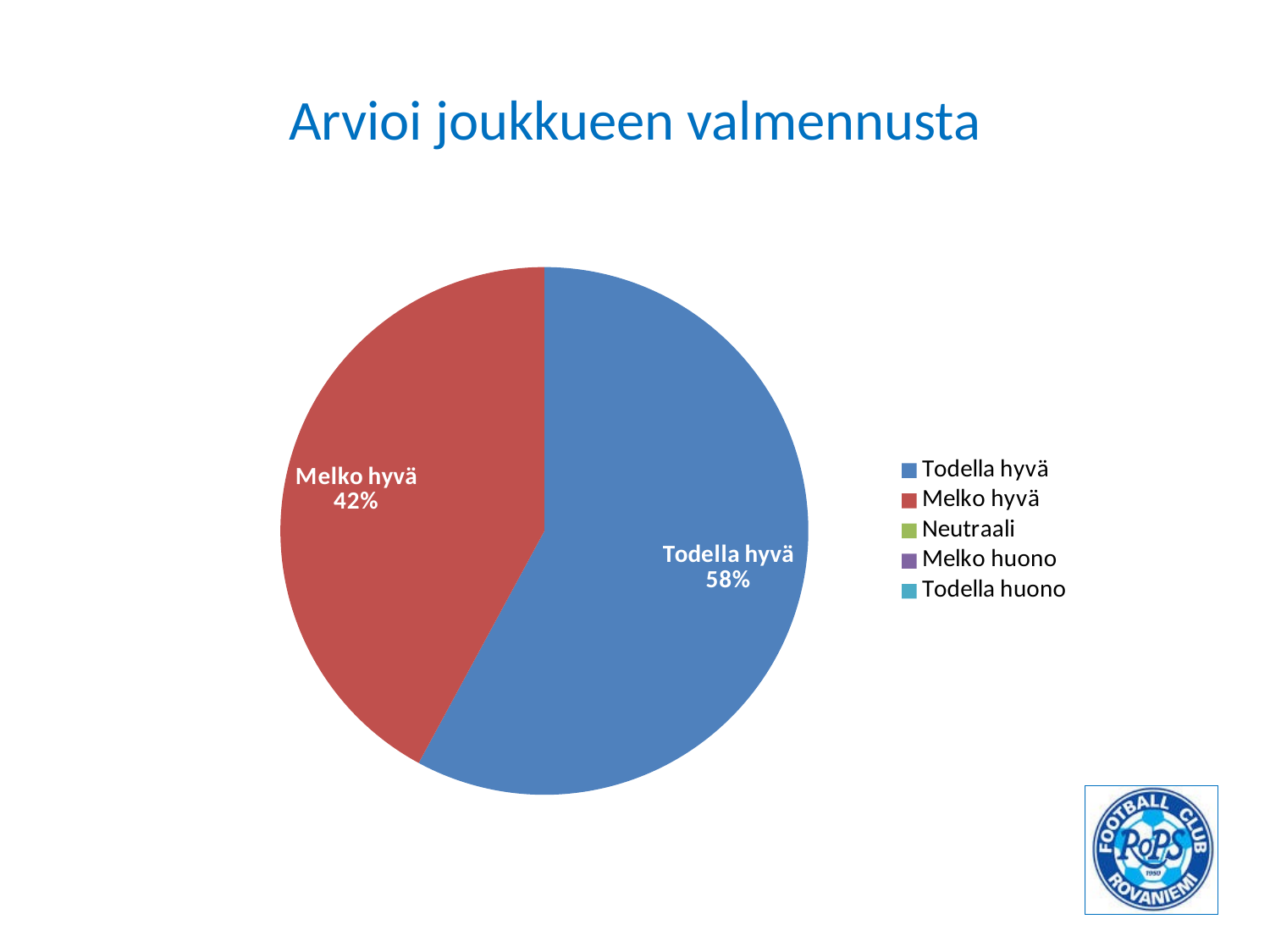
What kind of chart is shown on the slide? Pie chart Which of the two visible slices is smaller, "Todella hyvä" or "Melko hyvä"? Melko hyvä What colour is the "Todella hyvä" slice? Blue How many slices are visible in the pie? 2 Which category has the largest slice of the pie? Todella hyvä What is the difference in percentage points between the "Todella hyvä" and "Melko hyvä" slices? 16 percentage points What share of the pie does "Melko hyvä" represent? 42% What share of the pie does "Todella hyvä" represent? 58% What is the title of the slide? Arvioi joukkueen valmennusta Which is larger, the "Melko hyvä" slice or the "Todella hyvä" slice? Todella hyvä Is the share for "Todella hyvä" greater or less than 50%? greater How many categories does the legend list? 5